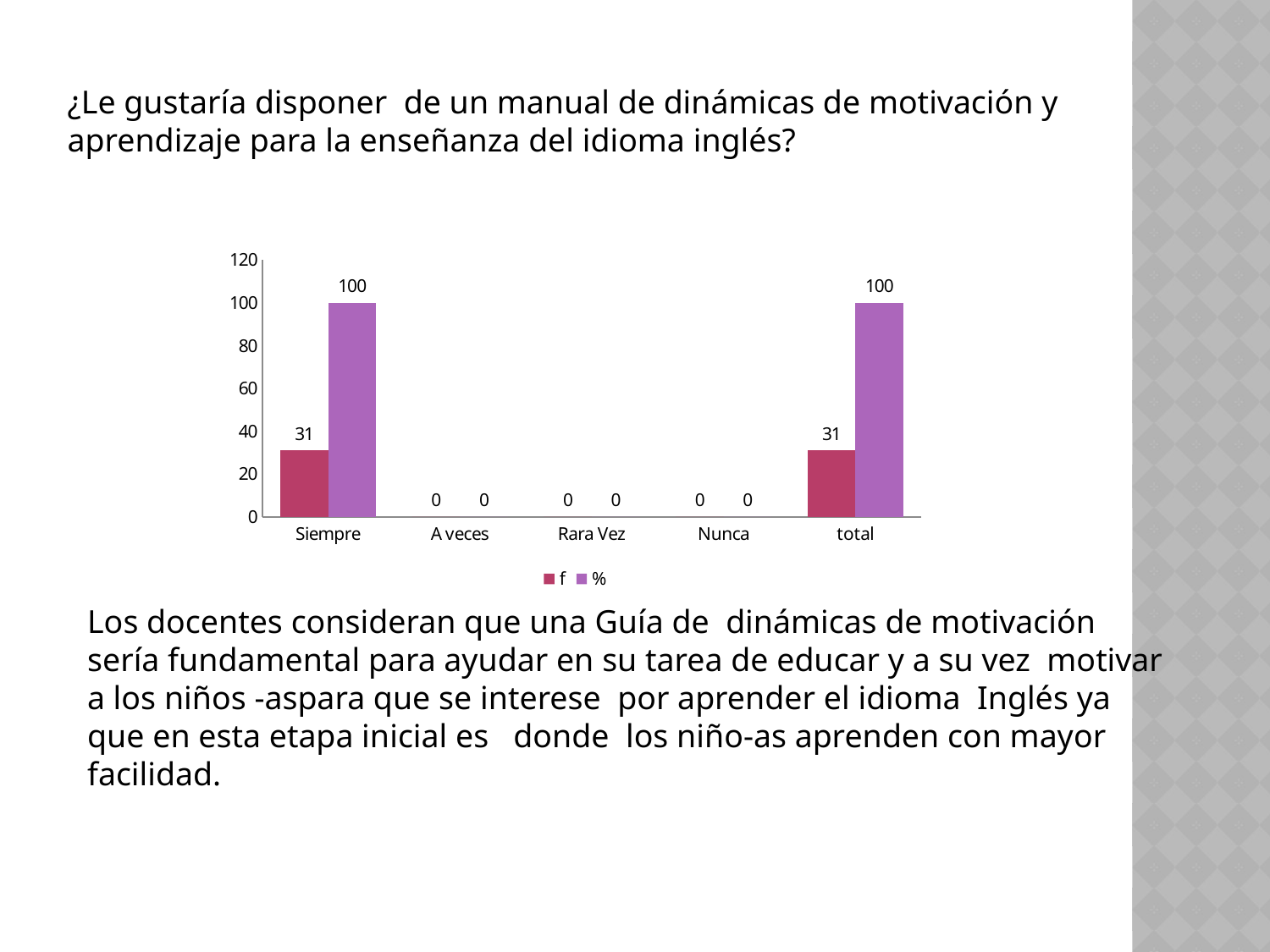
What is the value of the f series for Siempre? 31 What is the value of the f series for A veces? 0 What is the difference between the % value and the f value for Siempre? 69 What is the value of the % series for total? 100 How many categories are shown on the x axis? 5 What are the two series names listed in the legend? f and % What kind of chart is shown on the slide? bar chart How many series does the legend list? 2 Is the % value for Siempre greater or less than 80? greater What is the value of the % series for Siempre? 100 Which is larger for Siempre, the f value or the % value? % Which category has the highest value in the f series, excluding total? Siempre